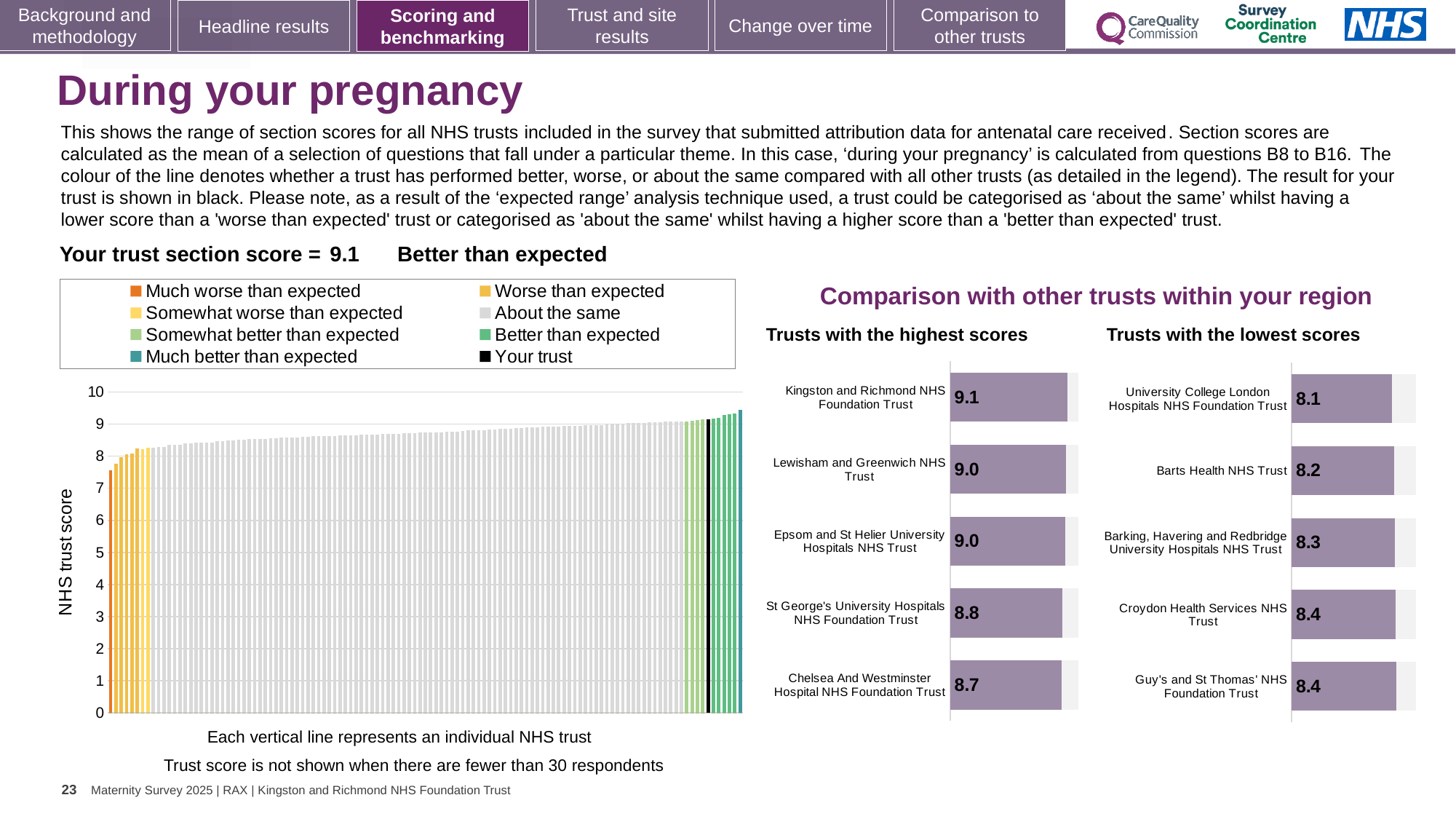
In the 'Trusts with the lowest scores' chart, which has the higher score: Barking, Havering and Redbridge University Hospitals NHS Trust or Croydon Health Services NHS Trust? Croydon Health Services NHS Trust How many trusts are shown in the 'Trusts with the highest scores' chart? 5 In the 'Trusts with the highest scores' chart, which trust has the highest score? Kingston and Richmond NHS Foundation Trust In the 'NHS trust score' chart on the left, is the value for the black 'Your trust' line greater or less than 8? greater In the 'NHS trust score' chart on the left, do the values rise or fall from left to right? rise In the 'Trusts with the lowest scores' chart, what is the score for Barts Health NHS Trust? 8.2 How many entries does the legend of the 'NHS trust score' chart on the left list? 8 In the 'Trusts with the lowest scores' chart, which trust has the lowest score? University College London Hospitals NHS Foundation Trust What kind of chart is the 'NHS trust score' chart on the left of the slide? bar chart In the 'Trusts with the highest scores' chart, what is the difference between the scores of Kingston and Richmond NHS Foundation Trust and Chelsea And Westminster Hospital NHS Foundation Trust? 0.4 In the 'Trusts with the highest scores' chart, what is the score for Chelsea And Westminster Hospital NHS Foundation Trust? 8.7 In the 'Trusts with the lowest scores' chart, what is the difference between the scores of Guy's and St Thomas' NHS Foundation Trust and University College London Hospitals NHS Foundation Trust? 0.3